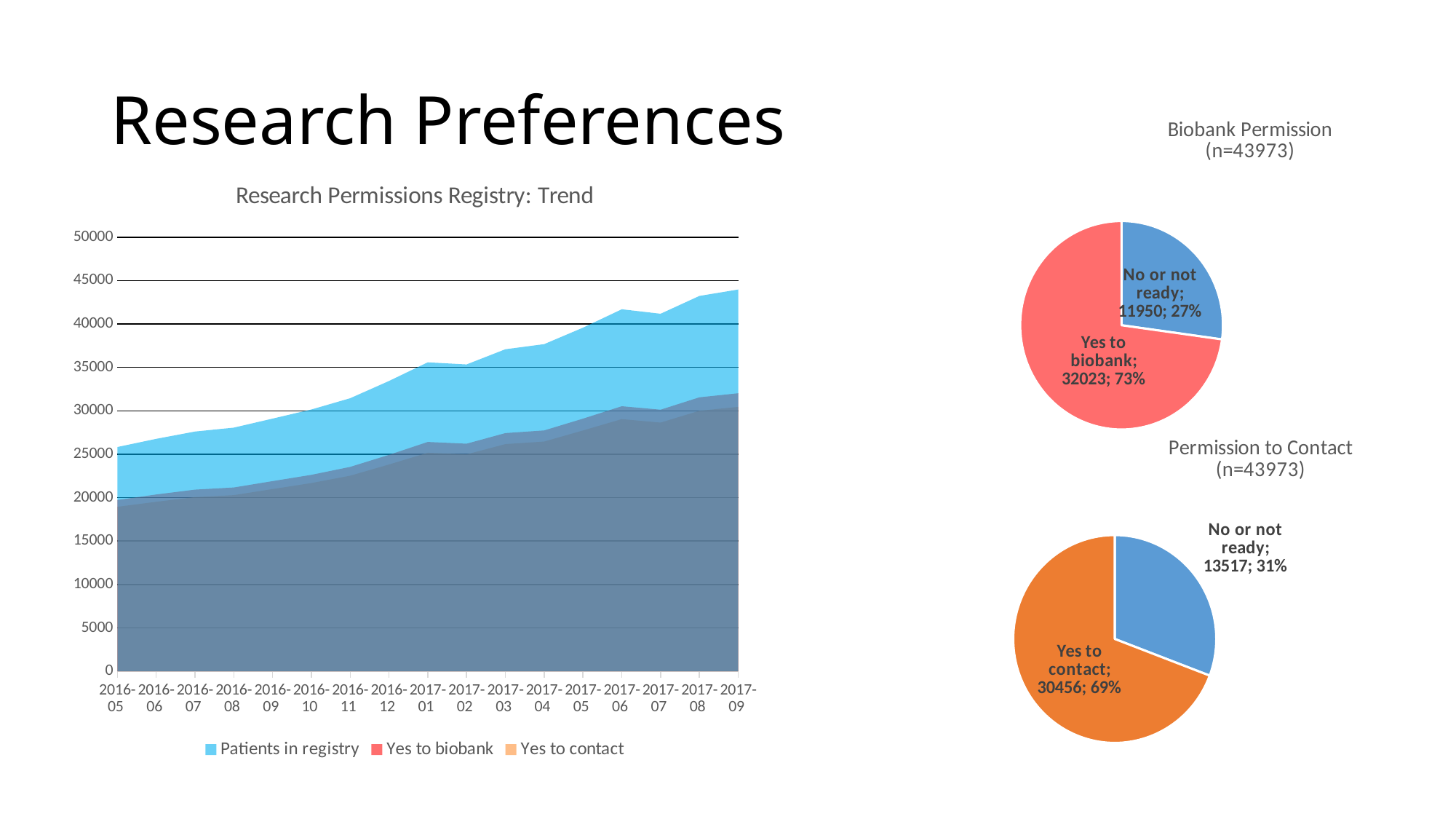
Which is larger: the 'Yes to biobank' count in the Biobank Permission chart or the 'Yes to contact' count in the Permission to Contact chart? Yes to biobank In the Permission to Contact pie chart, what is the difference between the 'Yes to contact' count and the 'No or not ready' count? 16939 What kind of chart is the Research Permissions Registry: Trend chart? Area chart In the Permission to Contact pie chart, how many patients said yes to contact? 30456 In the Research Permissions Registry: Trend chart, how many series does the legend list? 3 In the Research Permissions Registry: Trend chart, do the Patients in registry values rise or fall from 2016-05 to 2017-09? Rise In the Biobank Permission pie chart, what share of patients are 'No or not ready'? 27% In the Research Permissions Registry: Trend chart, is the value for Patients in registry at 2017-09 greater or less than 40000? greater In the Biobank Permission pie chart, what is the difference between the 'Yes to biobank' count and the 'No or not ready' count? 20073 In the Biobank Permission pie chart, how many patients said yes to biobank? 32023 In the Research Permissions Registry: Trend chart, how many time points are shown on the x axis? 17 In the Permission to Contact pie chart, what share of patients said yes to contact? 69%